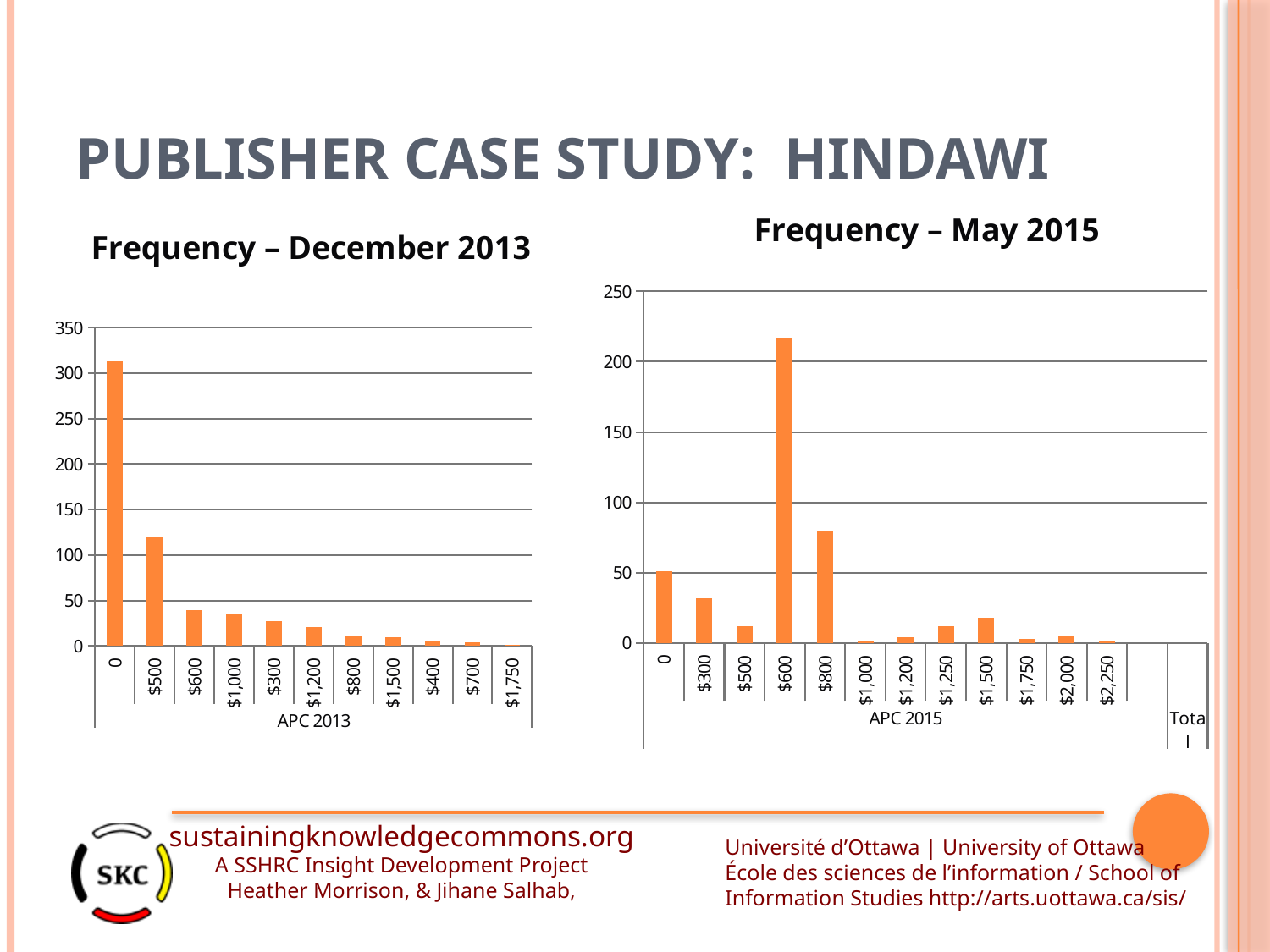
In the Frequency – December 2013 chart, which APC category has the highest frequency? 0 In the Frequency – May 2015 chart, is the value for $800 greater or less than 100? less In the Frequency – December 2013 chart, is the value for $600 greater or less than 50? less In the Frequency – December 2013 chart, is the value for the 0 category greater or less than 300? greater How many APC categories are shown on the x axis of the Frequency – December 2013 chart? 11 In the Frequency – May 2015 chart, which APC category has the highest frequency? $600 What kind of chart is the Frequency – December 2013 chart? bar chart What is the x-axis title of the Frequency – May 2015 chart? APC 2015 In the Frequency – December 2013 chart, which is larger, the value for $500 or the value for $600? $500 In the Frequency – May 2015 chart, which is larger, the value for 0 or the value for $300? 0